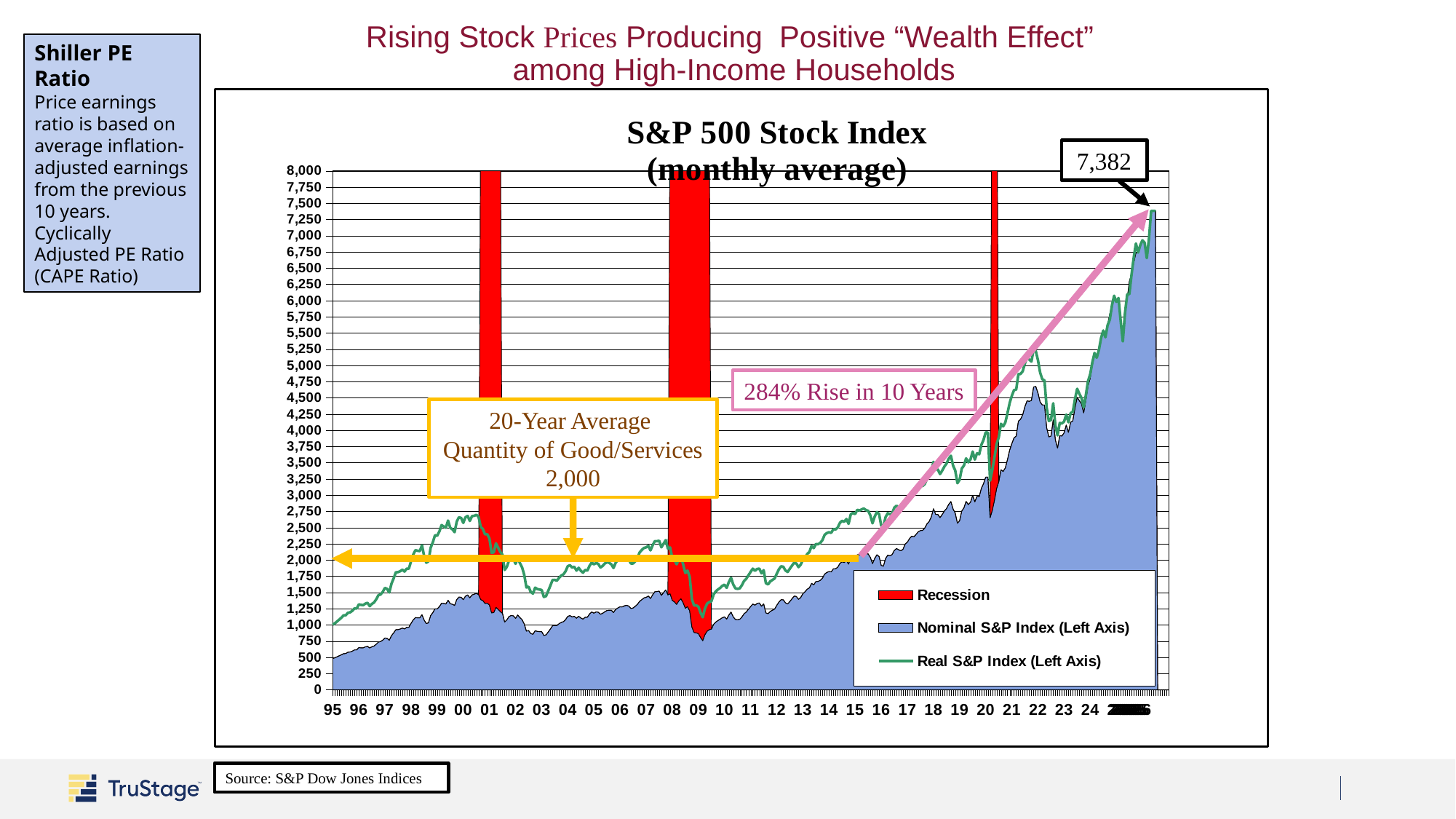
What is the title of the chart? S&P 500 Stock Index (monthly average) What is the latest value of the S&P 500 index labeled on the chart? 7,382 How many recession periods are shaded on the chart? 3 In 2000, which is higher: the Nominal S&P Index or the Real S&P Index? Real S&P Index Does the Nominal S&P Index generally rise or fall from 1995 to the end of the chart? rise Is the value of the Nominal S&P Index in 1995 greater or less than 1,000? less Is the value of the Real S&P Index at its 2000 peak greater or less than 2,500? greater What value is given for the 20-Year Average Quantity of Good/Services line? 2,000 How many series does the chart's legend list? 3 What percentage rise in 10 years does the chart annotation state? 284% Which is higher for the Nominal S&P Index: the value in 2022 or the value in 2009? 2022 Is the value of the Nominal S&P Index at its 2009 low greater or less than 1,000? less